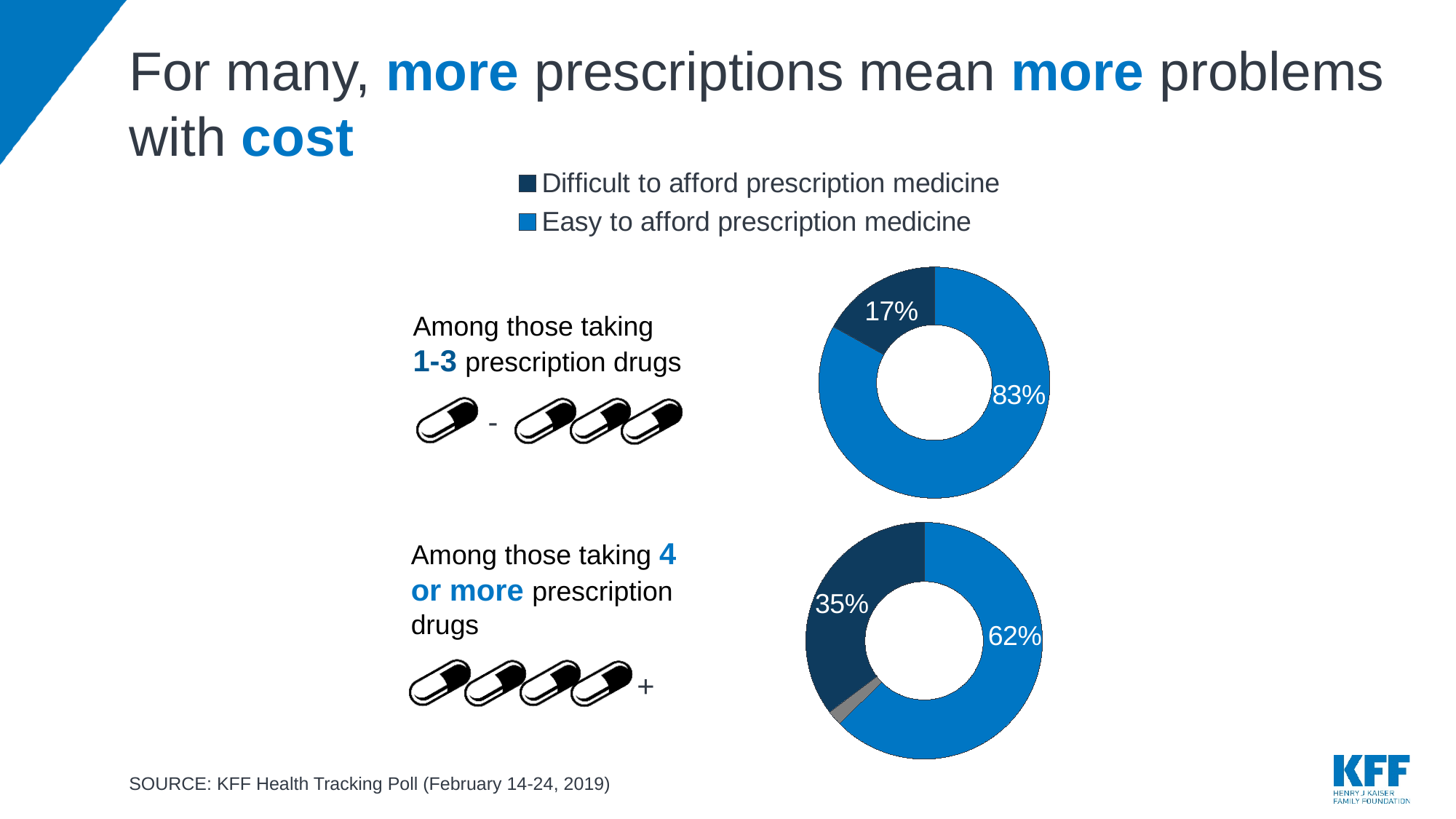
In the donut chart for those taking 4 or more prescription drugs, what share say it is easy to afford prescription medicine? 62% In the donut chart for those taking 4 or more prescription drugs, what share say it is difficult to afford prescription medicine? 35% How many entries does the legend list? 2 In the donut chart for those taking 1-3 prescription drugs, what share say it is easy to afford prescription medicine? 83% In the donut chart for those taking 1-3 prescription drugs, what is the difference between the easy and difficult shares? 66 percentage points How many donut charts are on the slide? 2 In the donut chart for those taking 4 or more prescription drugs, which is larger: the easy share or the difficult share? Easy to afford prescription medicine What is the difference between the share finding it difficult to afford prescription medicine among those taking 4 or more drugs and among those taking 1-3 drugs? 18 percentage points Which group has the larger share saying it is difficult to afford prescription medicine: those taking 1-3 drugs or those taking 4 or more? Those taking 4 or more Which legend entry is shown in the darker navy colour? Difficult to afford prescription medicine What kind of charts are shown on the slide? Donut (pie) charts In the donut chart for those taking 1-3 prescription drugs, what share say it is difficult to afford prescription medicine? 17%